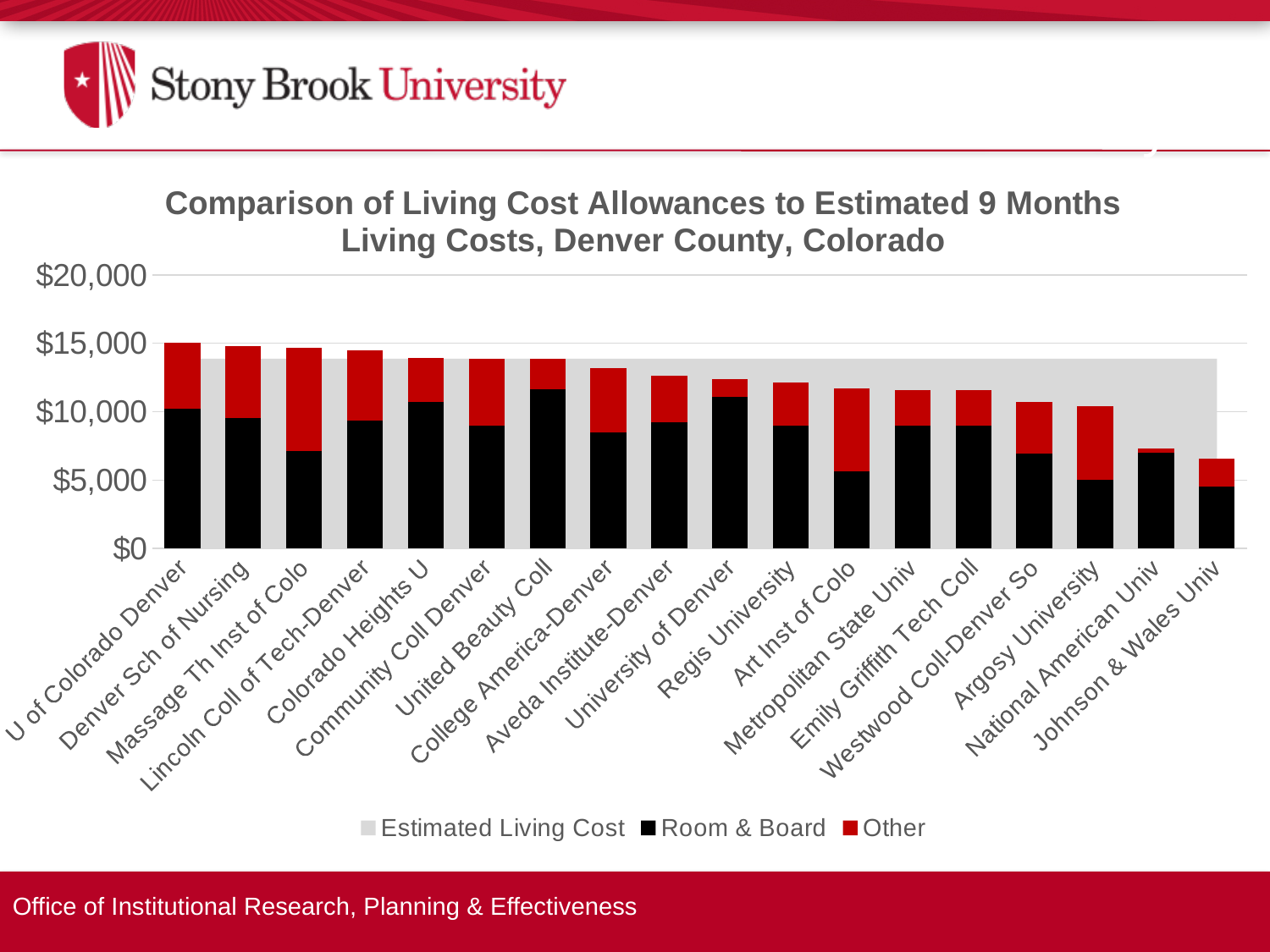
How many series does the chart's legend list? 3 How many institutions are shown along the x axis of the chart? 18 What kind of chart is shown on the slide? Stacked bar chart Is the Room & Board value for Art Inst of Colo greater or less than $10,000? less Is the total allowance for Johnson & Wales Univ greater or less than $10,000? less What colour represents the Room & Board series in the chart? Black Is the Room & Board value for United Beauty Coll greater or less than $10,000? greater Which institution has the lowest total living cost allowance (Room & Board plus Other)? Johnson & Wales Univ Do the total allowances generally rise or fall moving from left to right along the x axis? Fall Which has the larger Other value, Massage Th Inst of Colo or Regis University? Massage Th Inst of Colo Which has the larger Room & Board value, University of Denver or Art Inst of Colo? University of Denver